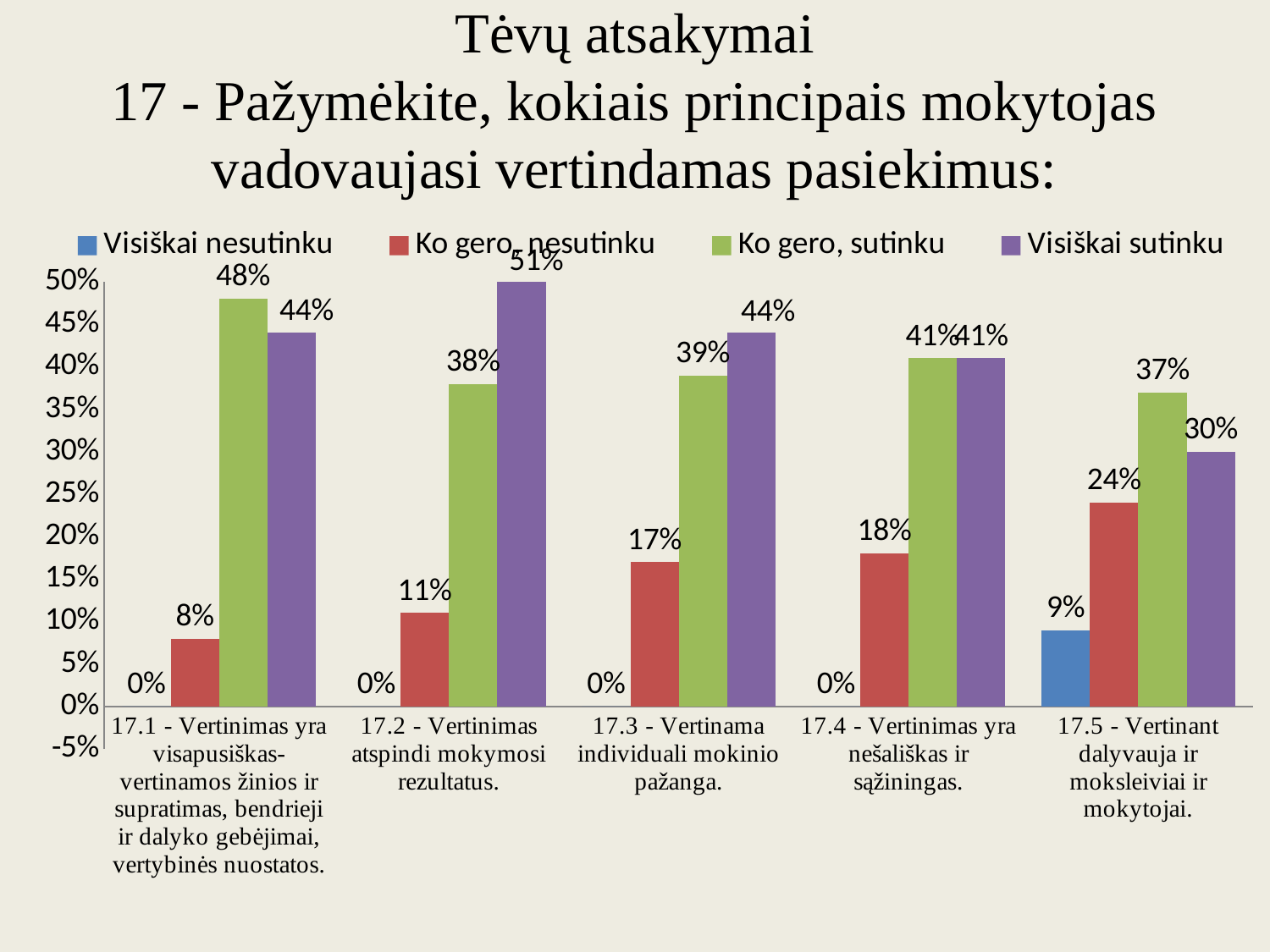
For category 17.5, which is larger: "Ko gero, sutinku" or "Visiškai sutinku"? Ko gero, sutinku What is the difference between "Ko gero, sutinku" and "Ko gero, nesutinku" for category 17.3? 22% What is the value of "Ko gero, nesutinku" for category 17.5? 24% How many categories are shown on the x axis? 5 What is the value of "Ko gero, sutinku" for category 17.1? 48% How many series does the legend list? 4 What type of chart is shown on the slide? bar chart What is the value of "Visiškai sutinku" for category 17.2? 51% Which series is shown in purple in the legend? Visiškai sutinku What is the value of "Visiškai nesutinku" for category 17.5? 9% Which category has the highest value for "Visiškai sutinku"? 17.2 - Vertinimas atspindi mokymosi rezultatus. Which category has the lowest value for "Ko gero, nesutinku"? 17.1 - Vertinimas yra visapusiškas- vertinamos žinios ir supratimas, bendrieji ir dalyko gebėjimai, vertybinės nuostatos.